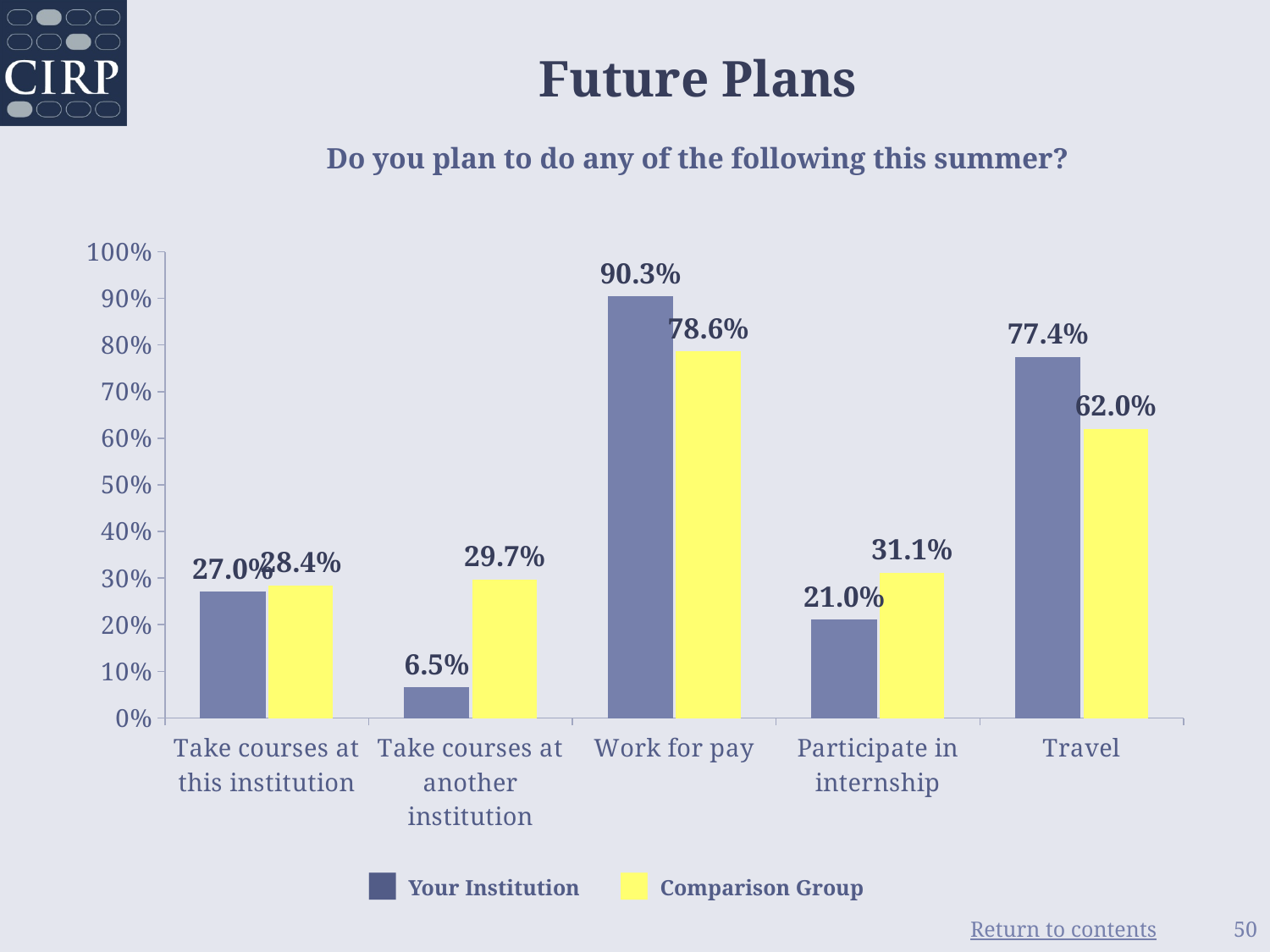
What is the value for Your Institution for Work for pay? 90.3% What colour represents the Comparison Group series? Yellow For Participate in internship, which is larger: Your Institution or Comparison Group? Comparison Group What kind of chart is shown on the slide? Bar chart What is the value for Comparison Group for Participate in internship? 31.1% How many series does the legend list? 2 What is the value for Your Institution for Take courses at another institution? 6.5% What is the difference between Your Institution and Comparison Group for Travel? 15.4% What is the value for Comparison Group for Travel? 62.0% Which category has the highest value for Your Institution? Work for pay Which category has the lowest value for Comparison Group? Take courses at this institution How many categories are shown on the x axis? 5